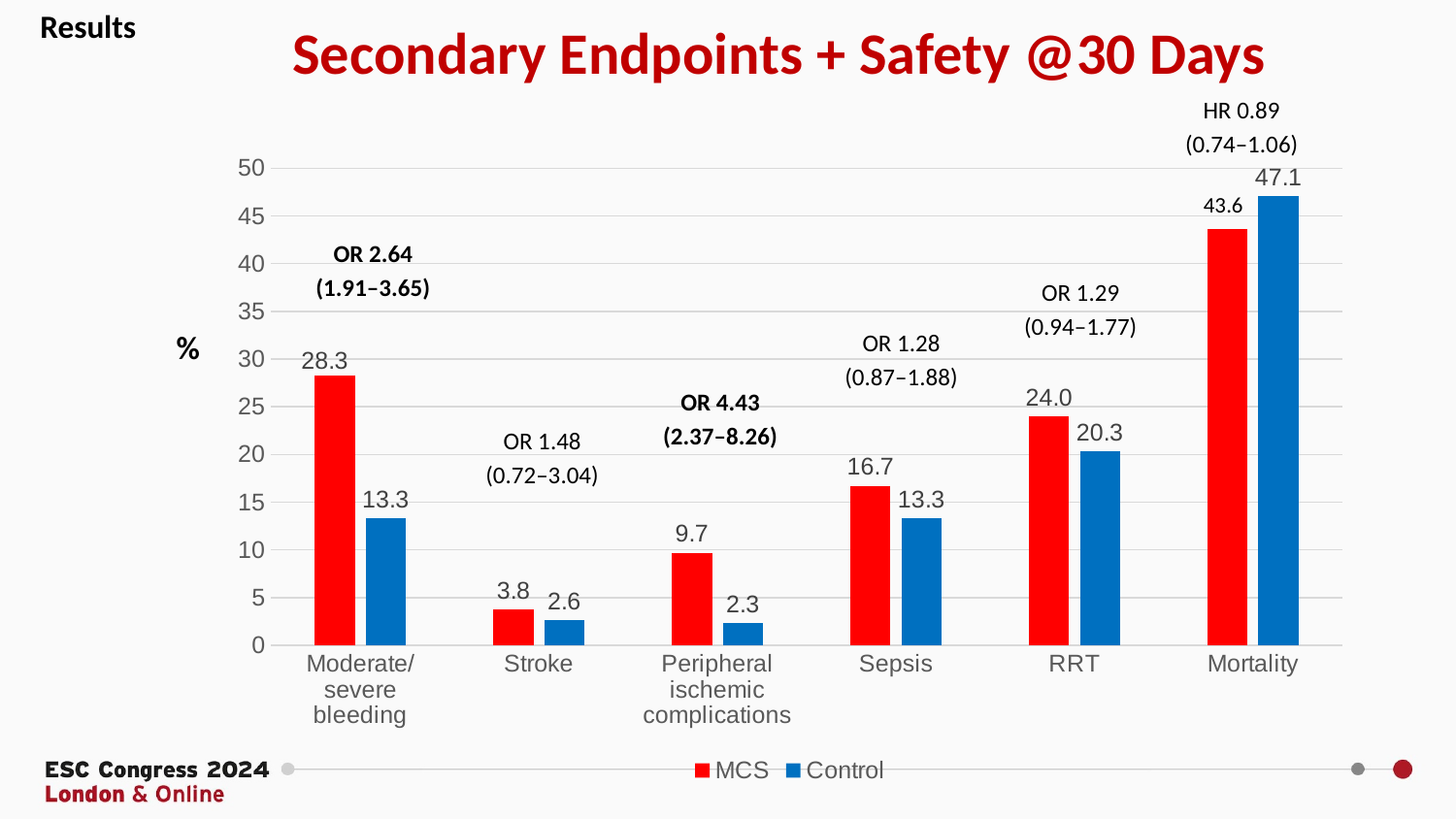
What is the Control value for Mortality? 47.1 What is the MCS value for Moderate/severe bleeding? 28.3 Which is larger for Sepsis, the MCS value or the Control value? MCS Which category has the lowest Control value? Peripheral ischemic complications How many categories are shown on the x axis? 6 How many series does the legend list? 2 Which category has the highest MCS value? Mortality What kind of chart is shown on the slide? Bar chart What is the difference between the MCS and Control values for Moderate/severe bleeding? 15.0 Which is larger for Mortality, the MCS value or the Control value? Control What is the difference between the MCS and Control values for RRT? 3.7 What is the Control value for Peripheral ischemic complications? 2.3